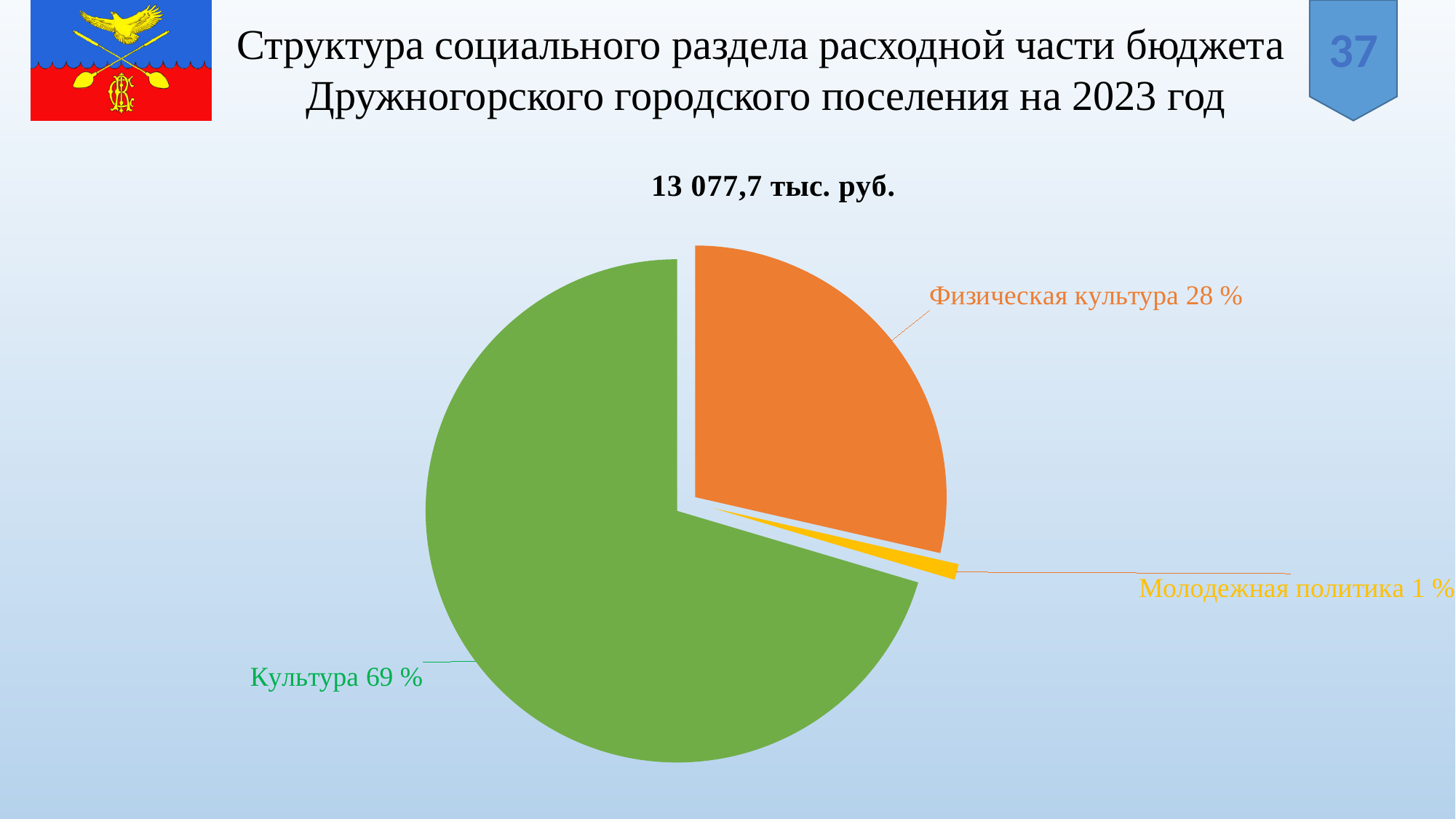
What kind of chart is shown on the slide? pie chart What share of the pie does Культура have? 69 % Which category has the smallest slice of the pie? Молодежная политика What is the difference in percentage points between Культура and Физическая культура? 41 What share of the pie does Молодежная политика have? 1 % What share of the pie does Физическая культура have? 28 % How many slices does the pie chart have? 3 Which is larger, the share for Физическая культура or the share for Молодежная политика? Физическая культура Which category has the largest slice of the pie? Культура What colour is the slice for Культура? green What total amount is shown above the pie chart? 13 077,7 тыс. руб.